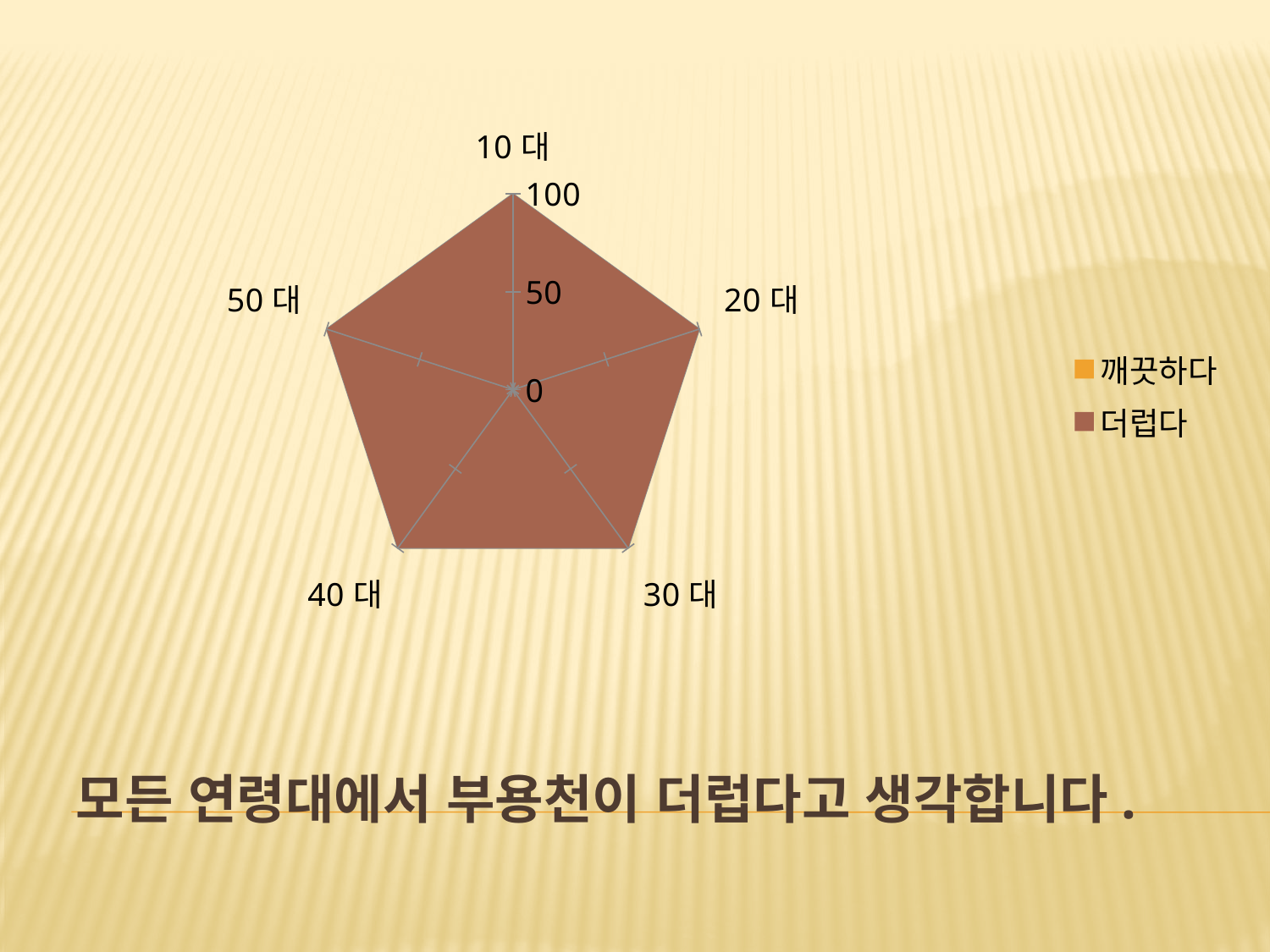
Is the value of 더럽다 for 40 대 greater or less than 50? greater Which series fills the entire pentagon of the radar chart? 더럽다 What is the value of 더럽다 for 30 대? 100 Which legend entry is shown in brown? 더럽다 What is the maximum value shown on the radar chart's axis? 100 Is the value of 더럽다 for 50 대 greater or less than 50? greater How many series does the legend list? 2 Is the value of 더럽다 for 20 대 greater or less than 50? greater What is the value of 더럽다 for 10 대? 100 How many age-group categories does the radar chart have? 5 What kind of chart is shown on the slide? radar chart